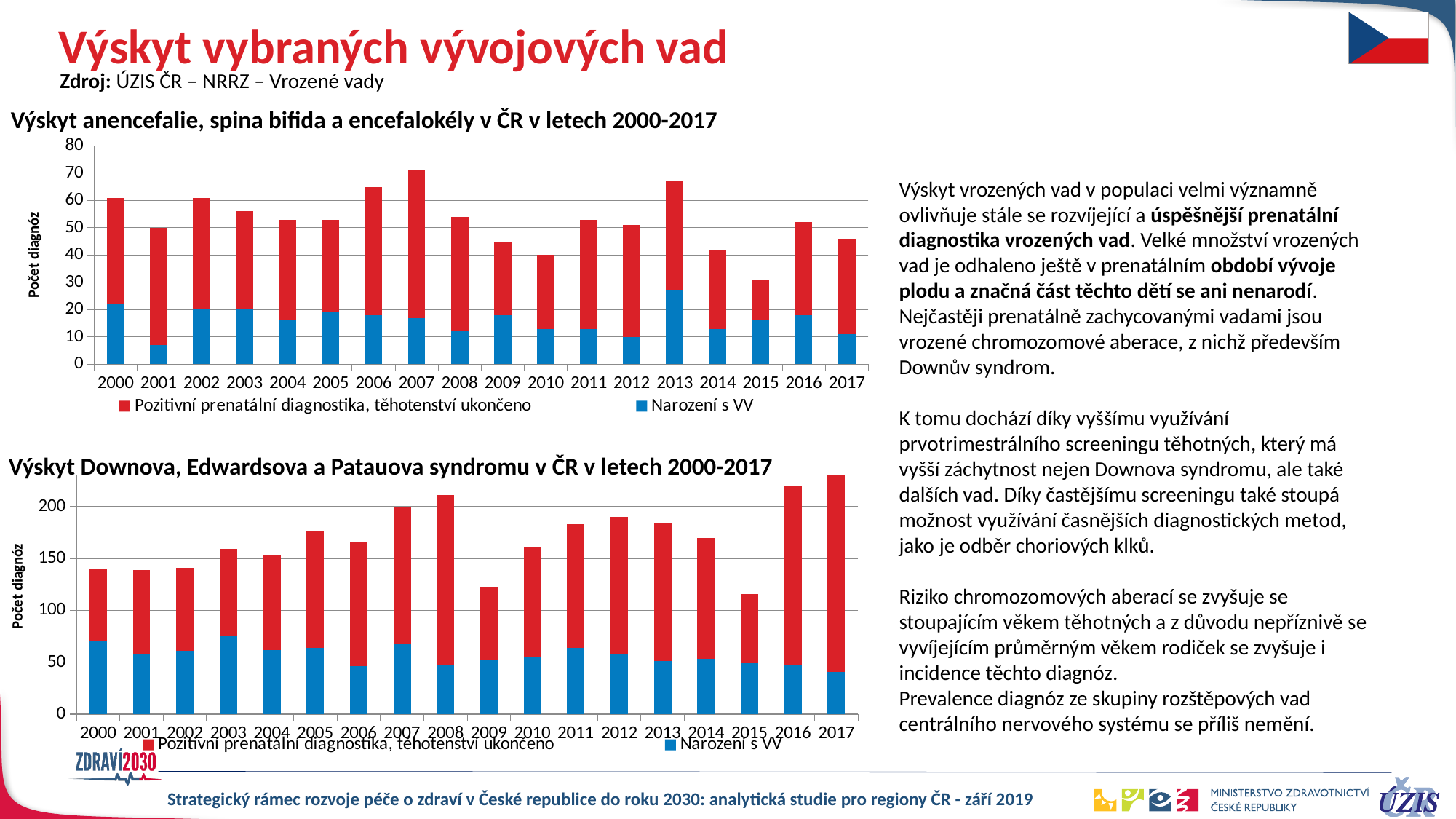
In the top chart (anencefalie, spina bifida a encefalokély), how many years are shown on the x axis? 18 How many series does the legend of the bottom chart (Downova, Edwardsova a Patauova syndromu) list? 2 In the top chart (anencefalie, spina bifida a encefalokély), is the total value for 2015 greater or less than 40? less In the top chart (anencefalie, spina bifida a encefalokély), which year has the lowest total number of diagnoses? 2015 In the top chart (anencefalie, spina bifida a encefalokély), is the total value for 2013 greater or less than 60? greater In the bottom chart (Downova, Edwardsova a Patauova syndromu), do the total values generally rise or fall from 2000 to 2017? Rise What kind of chart is the top chart, 'Výskyt anencefalie, spina bifida a encefalokély v ČR v letech 2000-2017'? Stacked bar chart In the bottom chart (Downova, Edwardsova a Patauova syndromu), which year has the larger total: 2016 or 2009? 2016 In the top chart (anencefalie, spina bifida a encefalokély), which colour represents the series 'Narození s VV'? Blue In the bottom chart (Downova, Edwardsova a Patauova syndromu), is the total value for 2000 greater or less than 150? less In the bottom chart (Downova, Edwardsova a Patauova syndromu), which year has the highest total number of diagnoses? 2017 In the top chart (anencefalie, spina bifida a encefalokély), which year has the highest total number of diagnoses? 2007